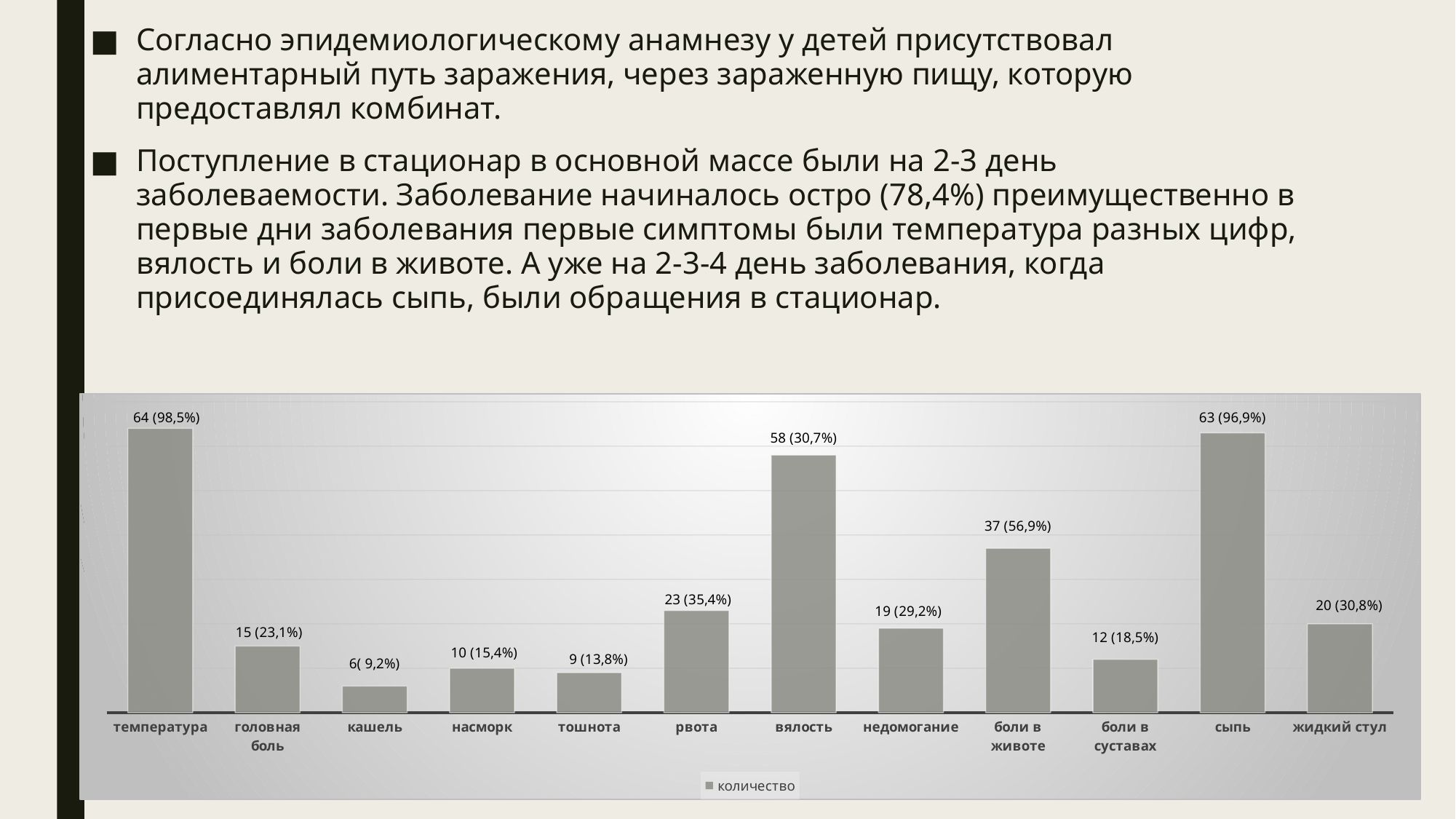
What value is shown for боли в животе? 37 (56,9%) What value is shown for сыпь? 63 (96,9%) Which category has the highest value? температура What is the difference in count between температура and сыпь? 1 Which is larger, the value for рвота or the value for недомогание? рвота What is the difference in count between вялость and боли в животе? 21 Which category has the lowest value? кашель How many series does the legend list? 1 What kind of chart is shown on the slide? bar chart What value is shown for температура? 64 (98,5%) How many categories are shown on the x axis? 12 What value is shown for кашель? 6( 9,2%)